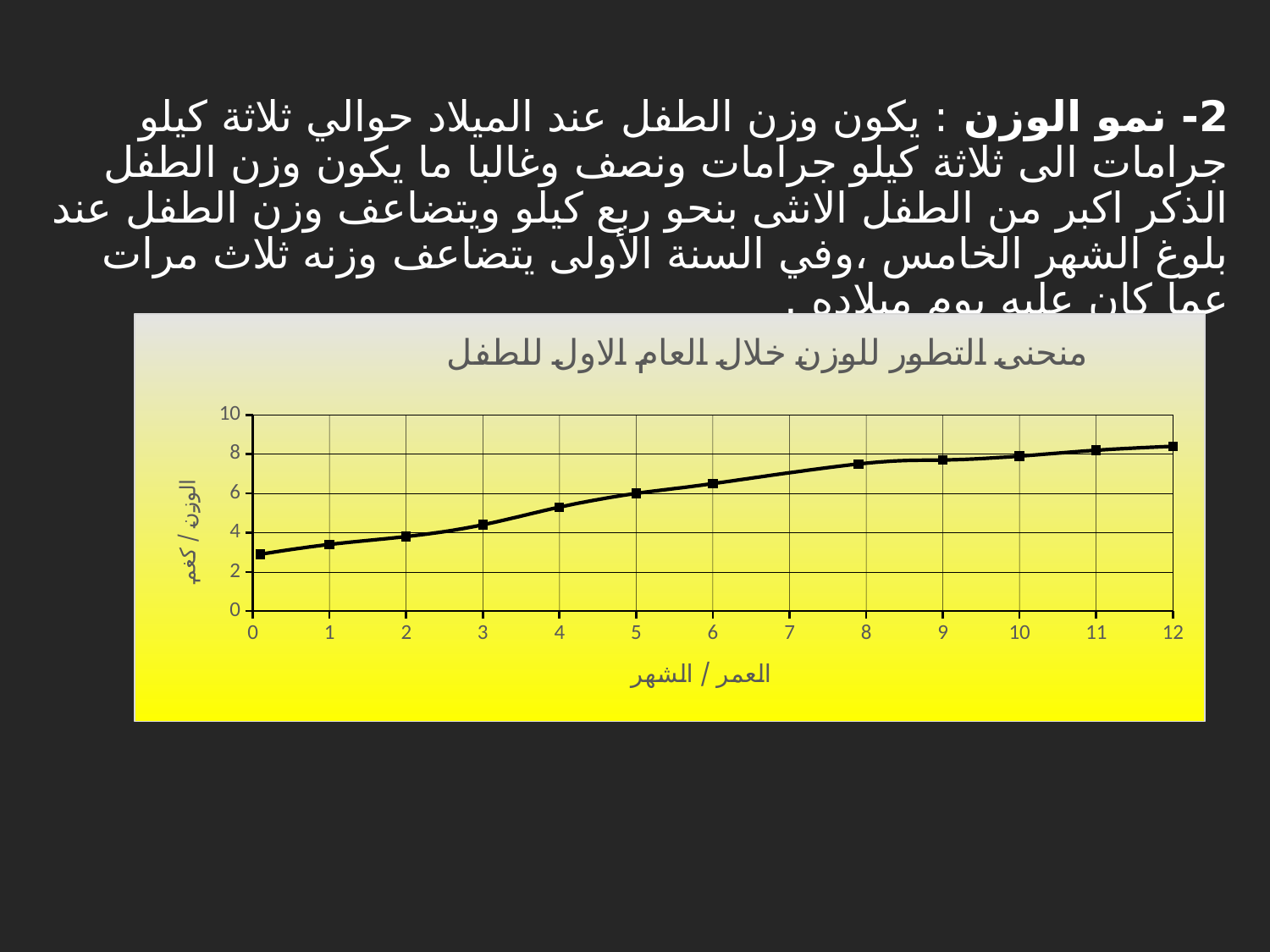
What is the label of the x axis? العمر / الشهر At which month is the weight highest? 12 At which month is the weight lowest? 0 Which is larger, the weight at month 2 or the weight at month 10? month 10 Is the weight at month 12 greater or less than 8? greater Is the weight at month 1 greater or less than 4? less What kind of chart is shown on the slide? line chart Do the values rise or fall as the age in months increases along the x axis? rise Is the weight at month 0 greater or less than 4? less What is the label of the y axis? الوزن / كغم